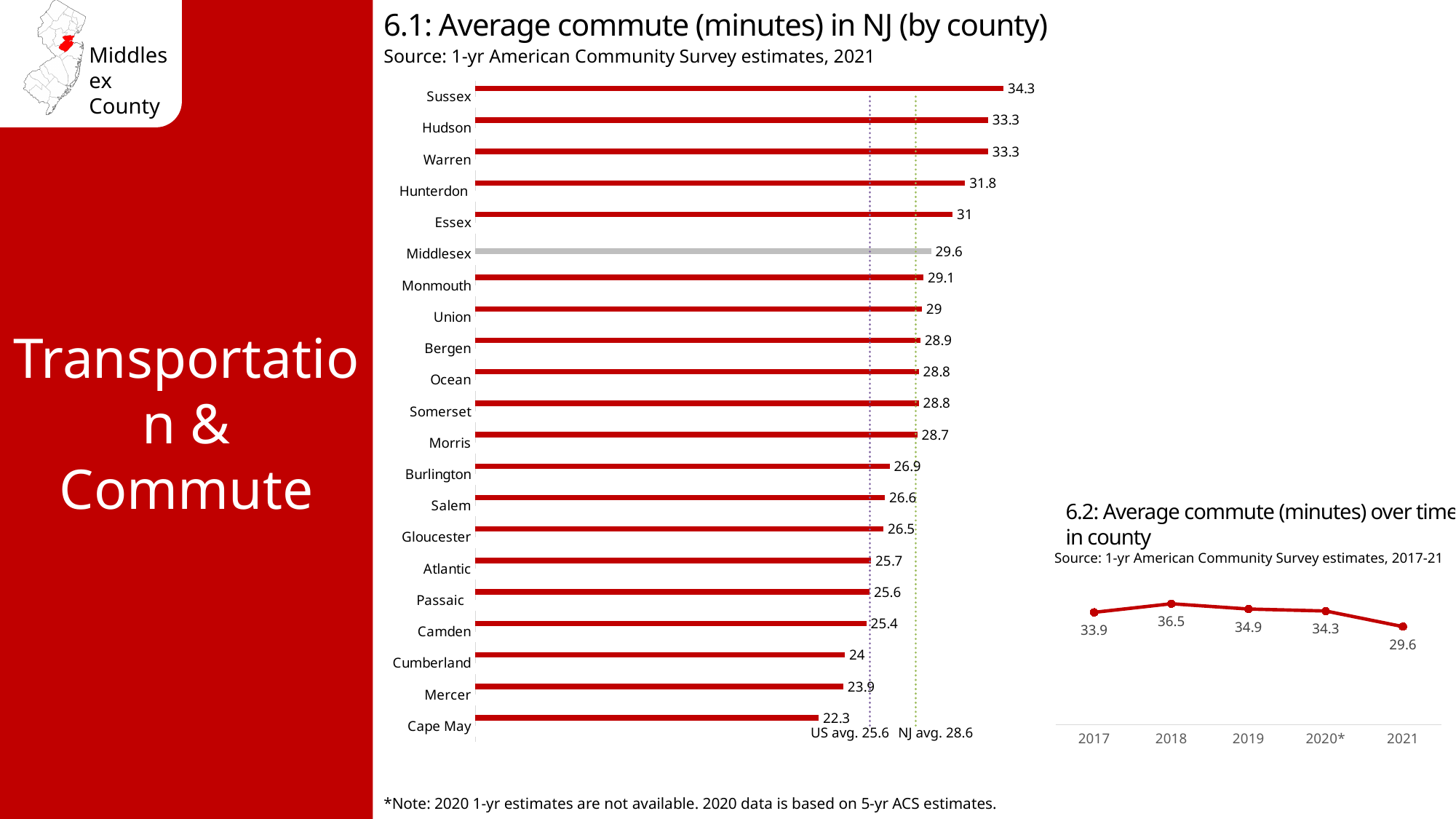
In chart 6.2 (Average commute over time in county), which year has the lowest value? 2021 In chart 6.2 (Average commute over time in county), what is the difference between the 2018 and 2021 values? 6.9 In chart 6.1 (Average commute in NJ by county), what is the average commute for Cumberland? 24 In chart 6.1 (Average commute in NJ by county), which has a longer average commute, Hunterdon or Essex? Hunterdon In chart 6.1 (Average commute in NJ by county), which county has the lowest average commute? Cape May In chart 6.1 (Average commute in NJ by county), what NJ average value is marked by the dotted reference line? 28.6 What kind of chart is chart 6.1 (Average commute in NJ by county)? Bar chart In chart 6.1 (Average commute in NJ by county), what is the difference between the Sussex and Cape May values? 12 In chart 6.1 (Average commute in NJ by county), how many counties are shown? 21 In chart 6.1 (Average commute in NJ by county), which county has the highest average commute? Sussex In chart 6.2 (Average commute over time in county), what is the value for 2018? 36.5 In chart 6.1 (Average commute in NJ by county), what is the average commute for Middlesex? 29.6